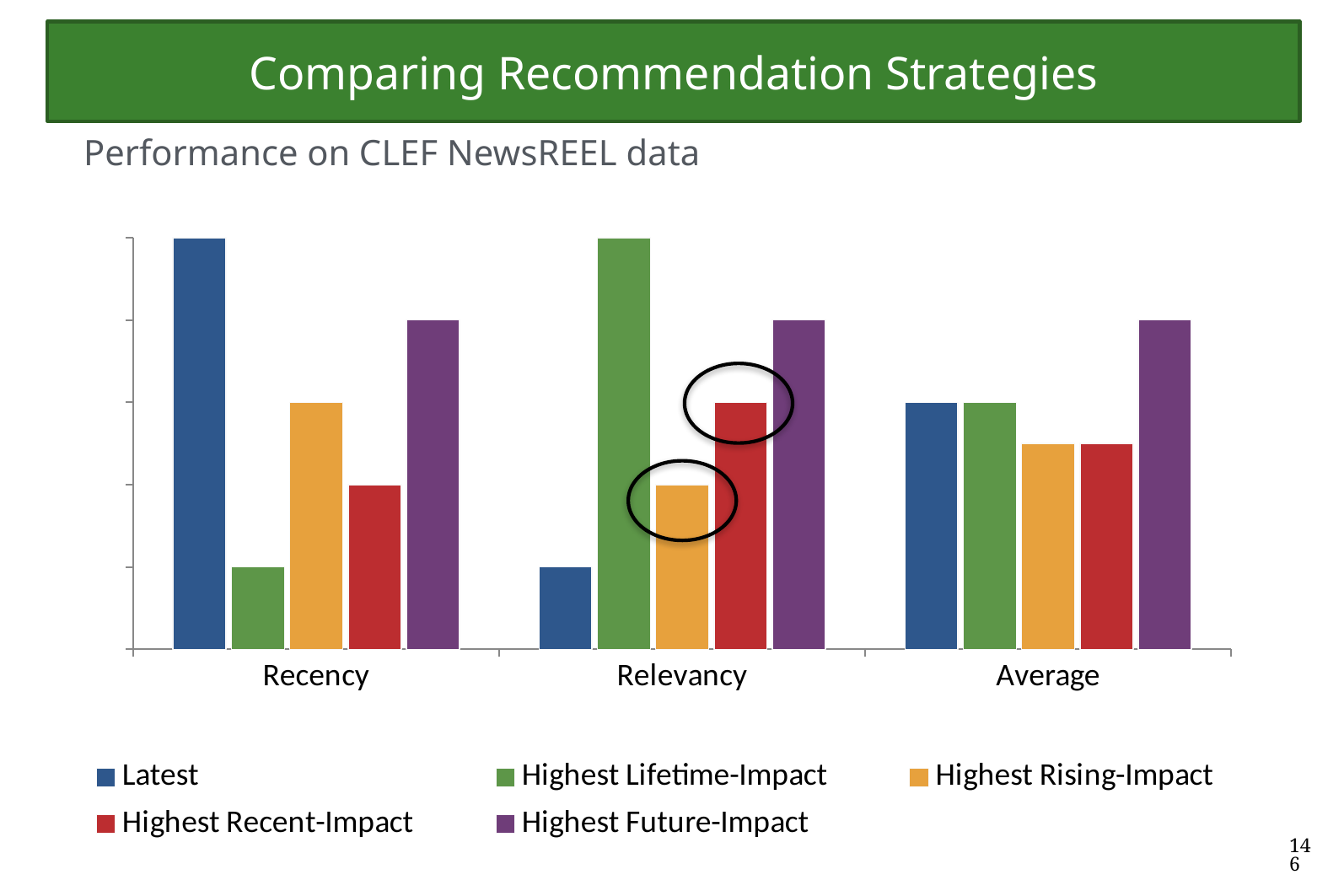
For the Latest series, which category has the larger bar: Recency or Average? Recency In the Recency category, which series has the highest bar? Latest How many series does the legend list? 5 How many categories are shown on the x axis? 3 In the Relevancy category, which series has the lowest bar? Latest What kind of chart is shown on the slide? bar chart In the Relevancy category, which series has the highest bar? Highest Lifetime-Impact In the Average category, which series has the highest bar? Highest Future-Impact What colour represents the Highest Future-Impact series in the legend? purple In the Recency category, which is larger: Highest Rising-Impact or Highest Recent-Impact? Highest Rising-Impact In the Relevancy category, which is larger: Highest Recent-Impact or Highest Rising-Impact? Highest Recent-Impact In the Recency category, which series has the lowest bar? Highest Lifetime-Impact